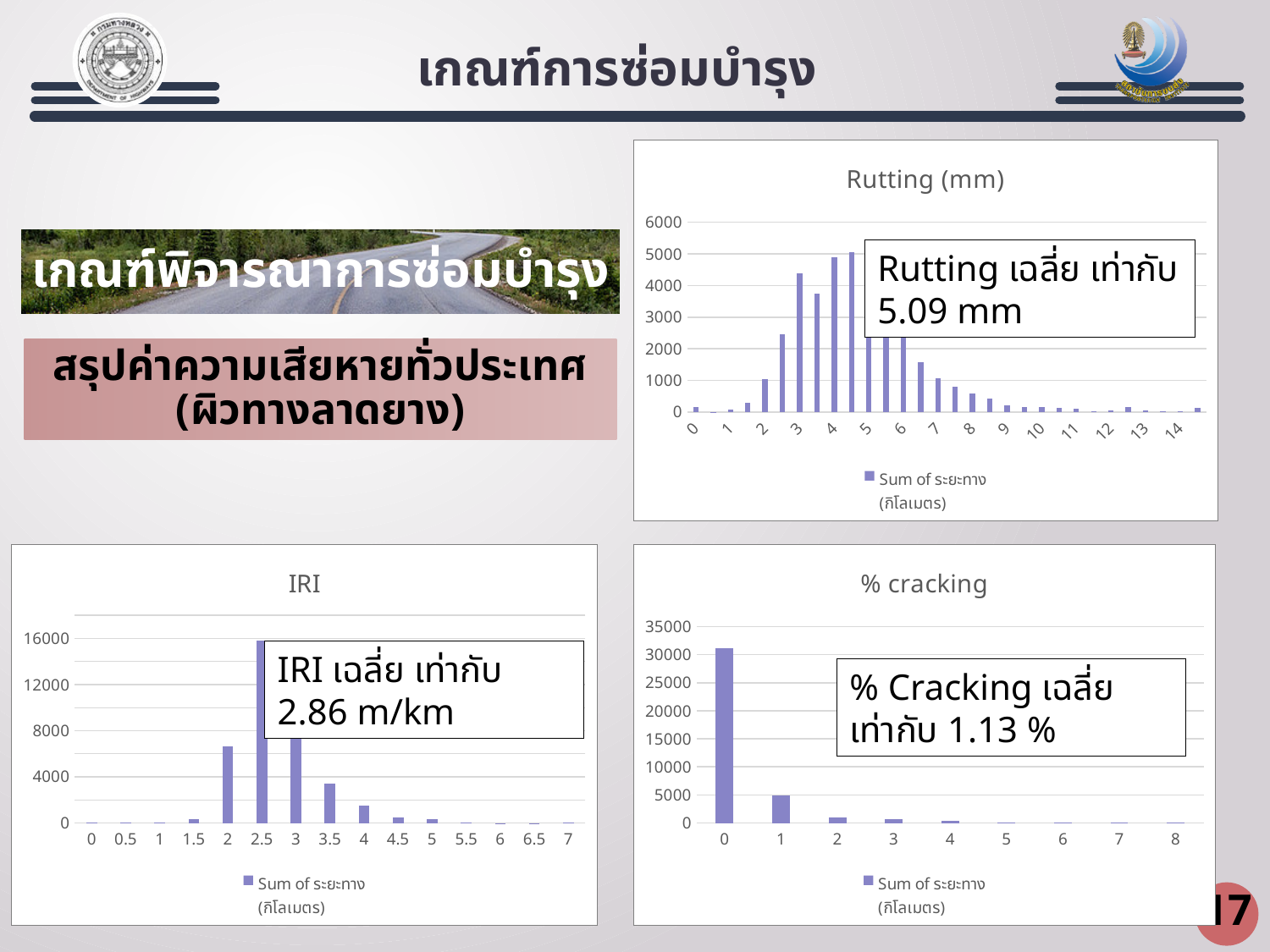
How many categories are shown on the x axis of the 'IRI' chart? 15 In the 'Rutting (mm)' chart, which is larger, the value for 6 or the value for 9? 6 In the 'IRI' chart, is the value for 2 greater or less than 4000? greater In the 'Rutting (mm)' chart, is the value for 8 greater or less than 1000? less In the 'Rutting (mm)' chart, is the value for 3 greater or less than 4000? greater According to the text box on the 'IRI' chart, what is the average IRI? 2.86 m/km In the 'IRI' chart, which category has the highest value? 2.5 How many series does the legend of the 'Rutting (mm)' chart list? 1 In the '% cracking' chart, which category has the highest value? 0 What kind of chart is the 'Rutting (mm)' chart? bar chart